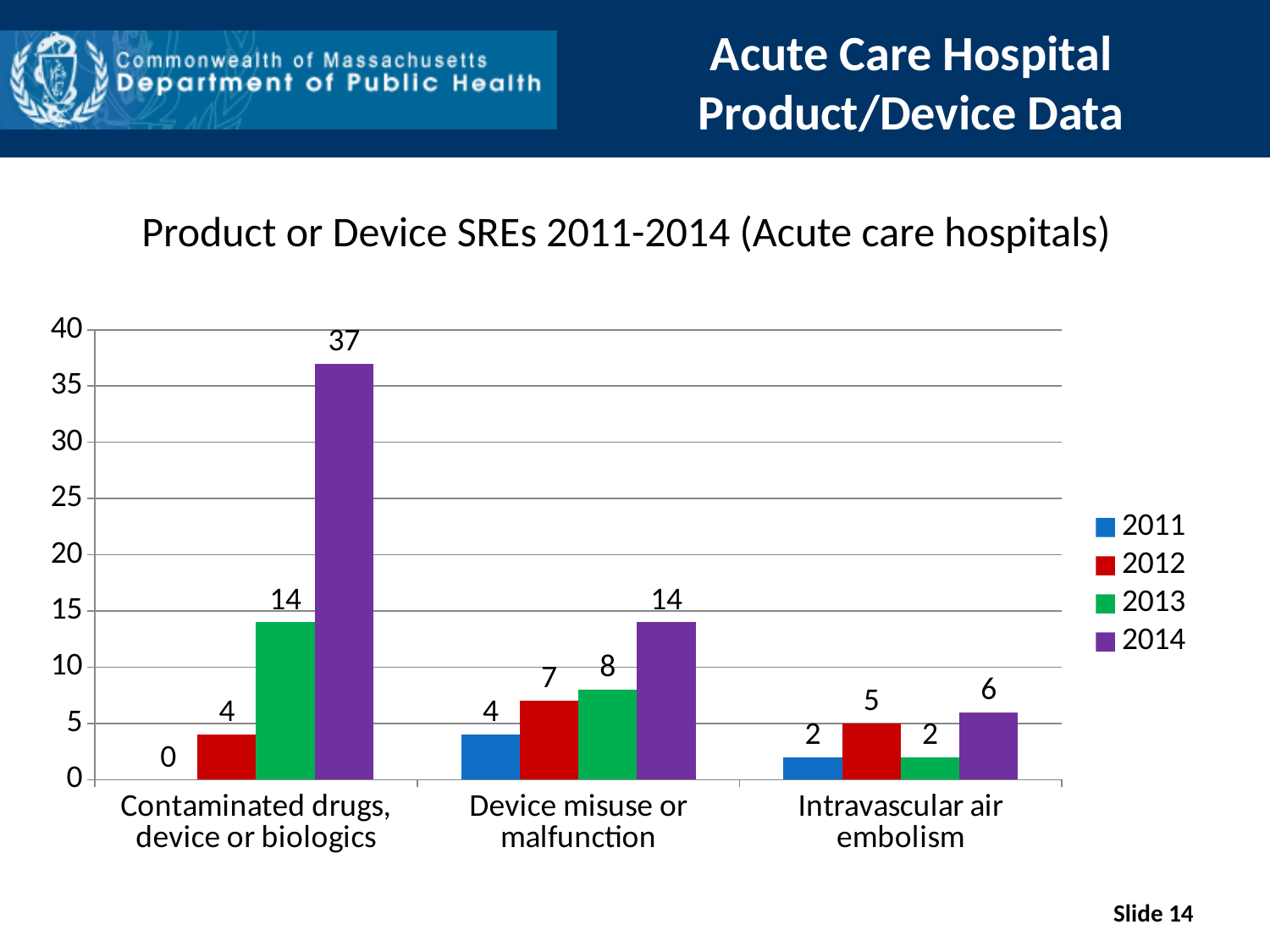
What is the value for 2011 in the Device misuse or malfunction category? 4 How many categories are shown on the x axis? 3 What kind of chart is this? Bar chart Which year has the lowest value in the Intravascular air embolism category? 2011 and 2013 (both 2) What is the value for 2014 in the Contaminated drugs, device or biologics category? 37 Do the values for Contaminated drugs, device or biologics rise or fall from 2011 to 2014? Rise What is the difference between the 2014 and 2013 values in the Contaminated drugs, device or biologics category? 23 Which is larger: the 2012 value for Device misuse or malfunction or the 2012 value for Intravascular air embolism? Device misuse or malfunction How many series does the legend list? 4 What is the value for 2012 in the Intravascular air embolism category? 5 What is the title of the chart? Product or Device SREs 2011-2014 (Acute care hospitals) Which year has the highest value in the Contaminated drugs, device or biologics category? 2014